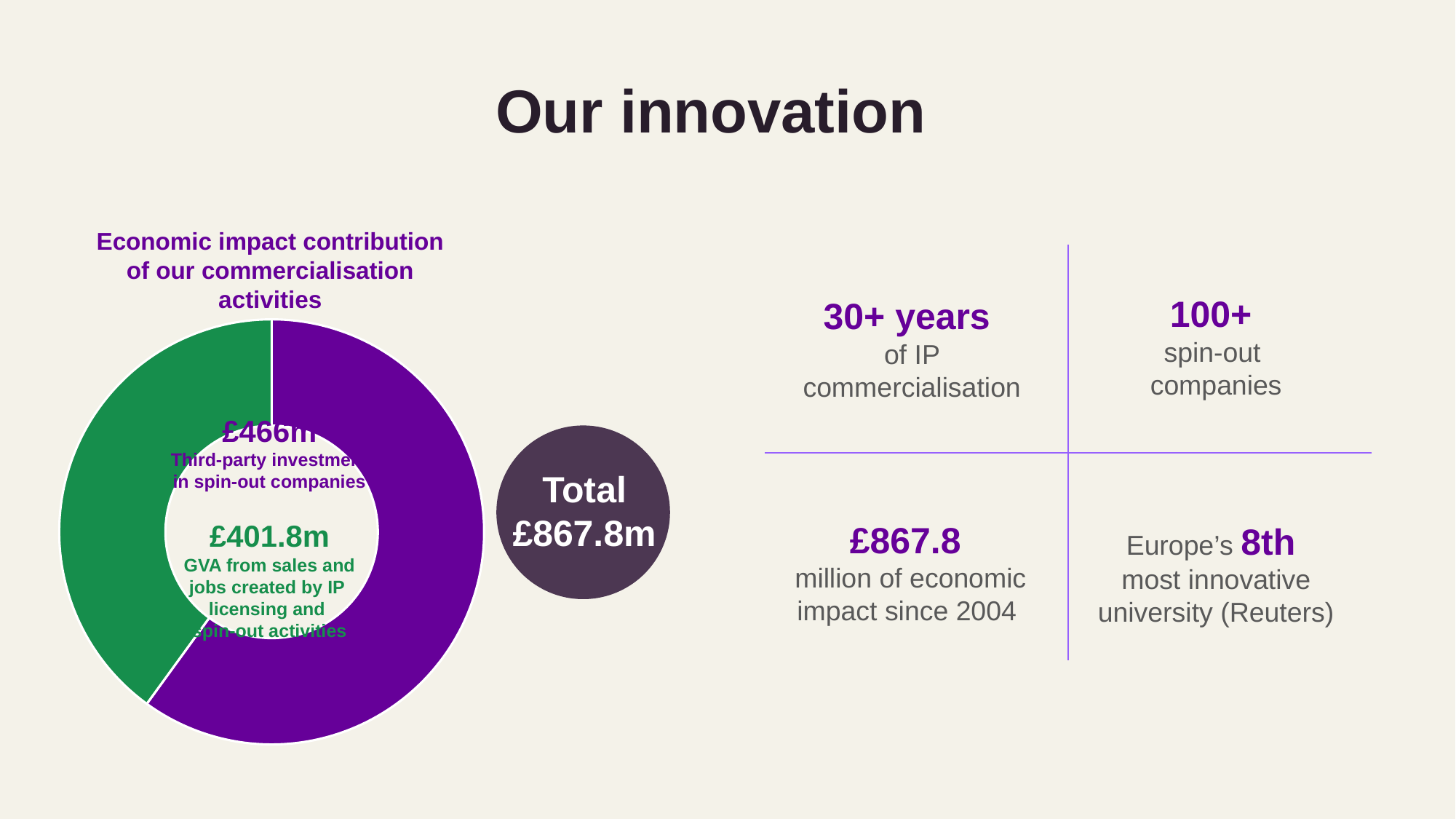
Which segment of the chart is the smallest? GVA from sales and jobs created by IP licensing and spin-out activities Which segment of the chart is the largest? Third-party investment in spin-out companies What is the total of the two segments shown on the chart? £867.8m What is the difference between the third-party investment segment and the GVA segment? £64.2m What is the value of the GVA from sales and jobs created by IP licensing and spin-out activities segment? £401.8m What is the value of the third-party investment in spin-out companies segment? £466m What share of the total does the third-party investment in spin-out companies segment represent? 53.7% What is the title of the chart on the slide? Economic impact contribution of our commercialisation activities What kind of chart is shown on the slide? pie chart (donut) How many segments does the chart have? 2 Which is larger: third-party investment in spin-out companies or GVA from sales and jobs created by IP licensing and spin-out activities? Third-party investment in spin-out companies What colour is the segment representing third-party investment in spin-out companies? purple